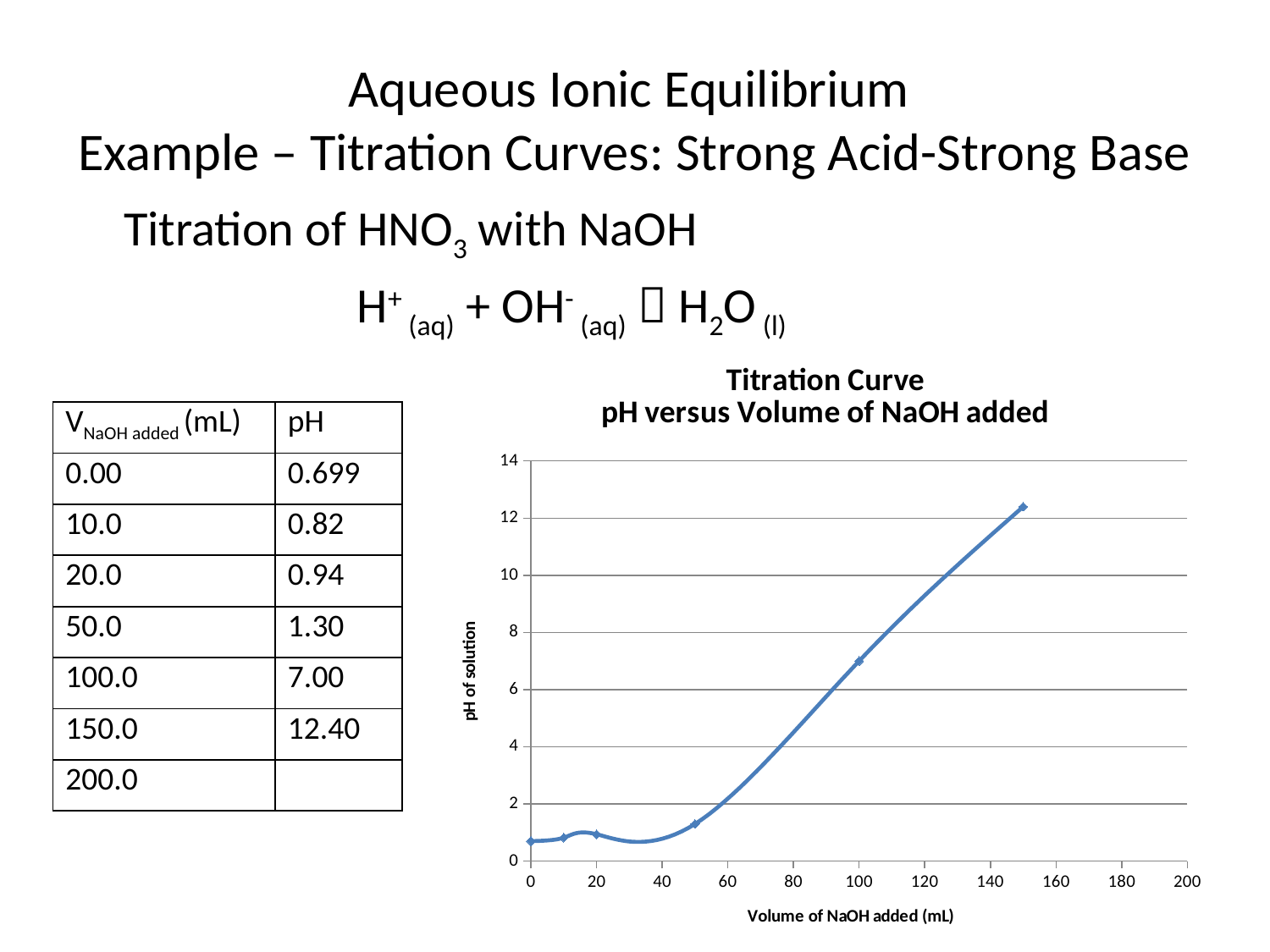
What is the pH before any NaOH is added (0.00 mL)? 0.699 What is the difference in pH between 150.0 mL and 100.0 mL of NaOH added? 5.40 How many data points are plotted on the titration curve? 6 Does the pH rise or fall as the volume of NaOH added increases along the x axis? rise What is the title of the chart? Titration Curve pH versus Volume of NaOH added At which volume of NaOH added is the plotted pH lowest? 0.00 mL What kind of chart is shown on the slide? line chart Is the pH at 150 mL of NaOH added greater or less than 12? greater At which volume of NaOH added is the plotted pH highest? 150.0 mL What is the pH when 150.0 mL of NaOH has been added? 12.40 What is the label of the vertical axis of the chart? pH of solution What is the pH when 100.0 mL of NaOH has been added? 7.00